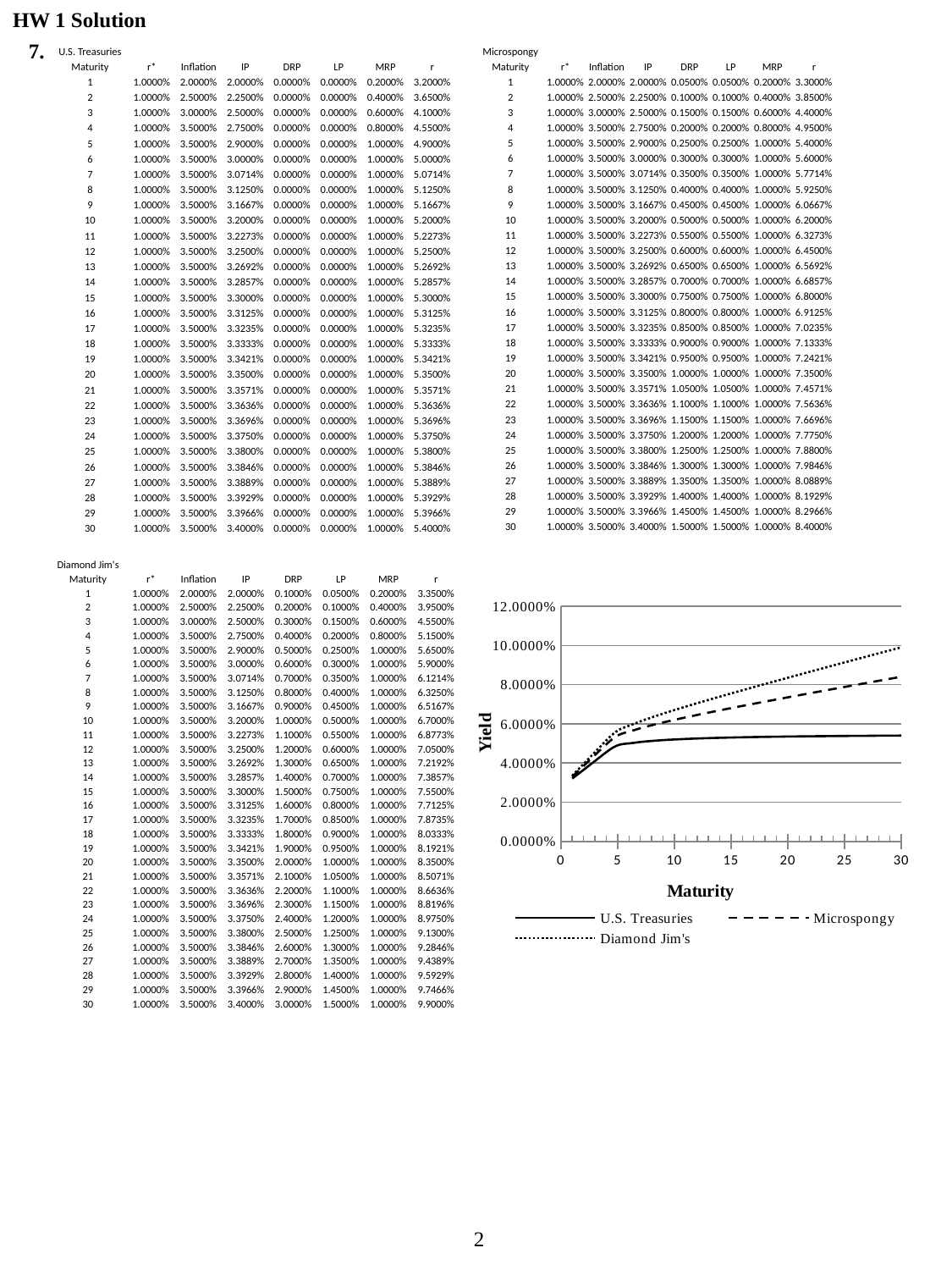
Which series has the lowest yield at maturity 30? U.S. Treasuries Which series is drawn with a dotted line in the chart? Diamond Jim's Is the Microspongy yield at maturity 30 greater or less than 6.0000%? greater How many series does the chart's legend list? 3 Is the U.S. Treasuries yield at maturity 30 greater or less than 6.0000%? less Which series has the highest yield at maturity 30? Diamond Jim's What kind of chart is shown on the slide? line chart Is the U.S. Treasuries yield at maturity 1 greater or less than 4.0000%? less What is the label of the chart's y axis? Yield At maturity 30, which series has the higher yield, Microspongy or U.S. Treasuries? Microspongy Do the yields rise or fall as maturity increases along the x axis? rise